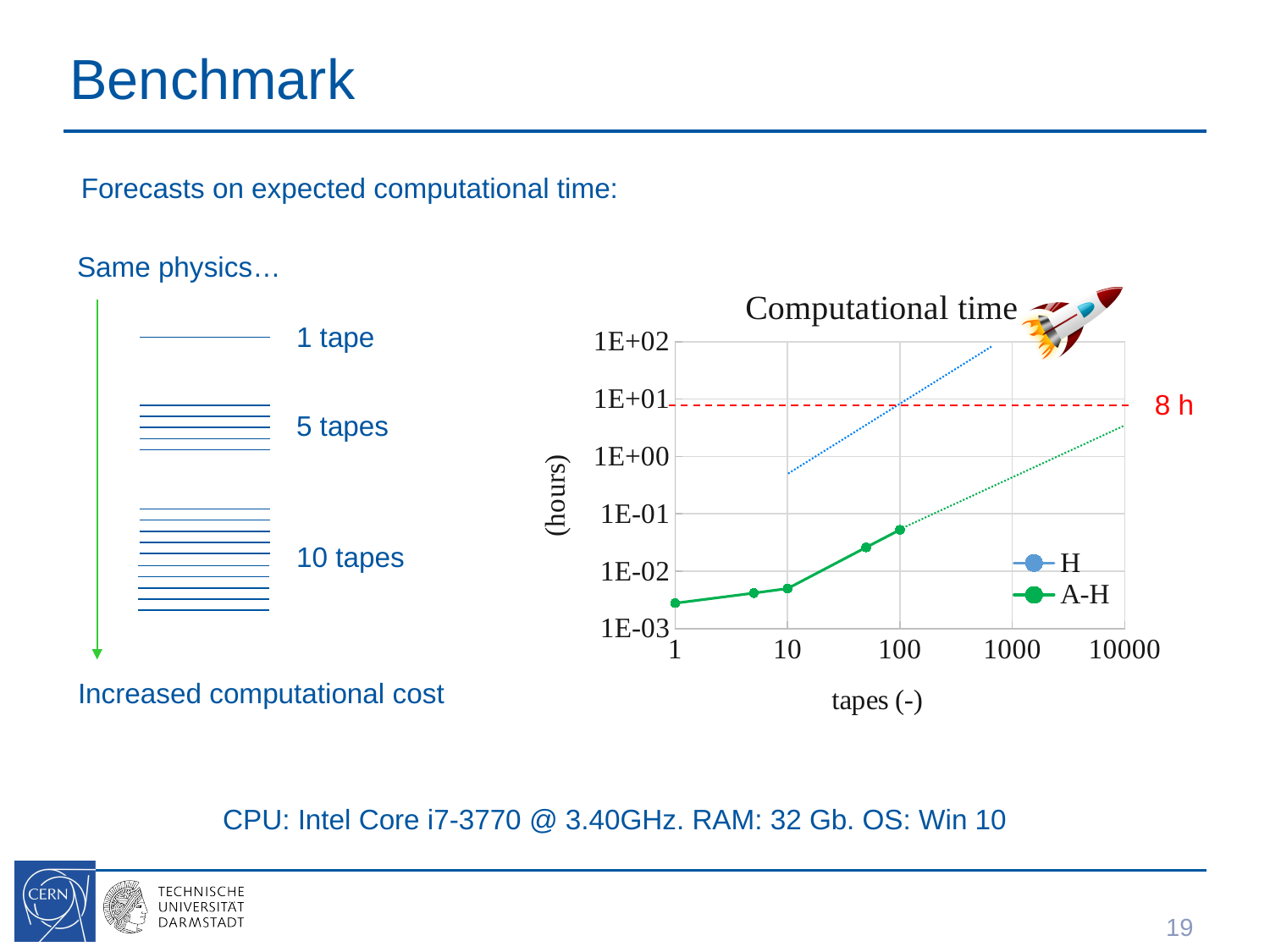
What value does the red dashed horizontal line mark? 8 h Is the H value at 10 tapes greater or less than 1E+00 hours? less Is the A-H value at 100 tapes greater or less than 1E-01 hours? less How many series does the chart legend list? 2 At 100 tapes, which series has the higher computational time, H or A-H? H How many data points are marked on the A-H series? 5 What kind of chart is shown? line chart What is the label of the x axis? tapes (-) What are the names of the two series in the legend? H and A-H Does the computational time for the A-H series rise or fall as the number of tapes increases? rise What is the title of the chart? Computational time Is the A-H value at 1 tape greater or less than 1E-02 hours? less